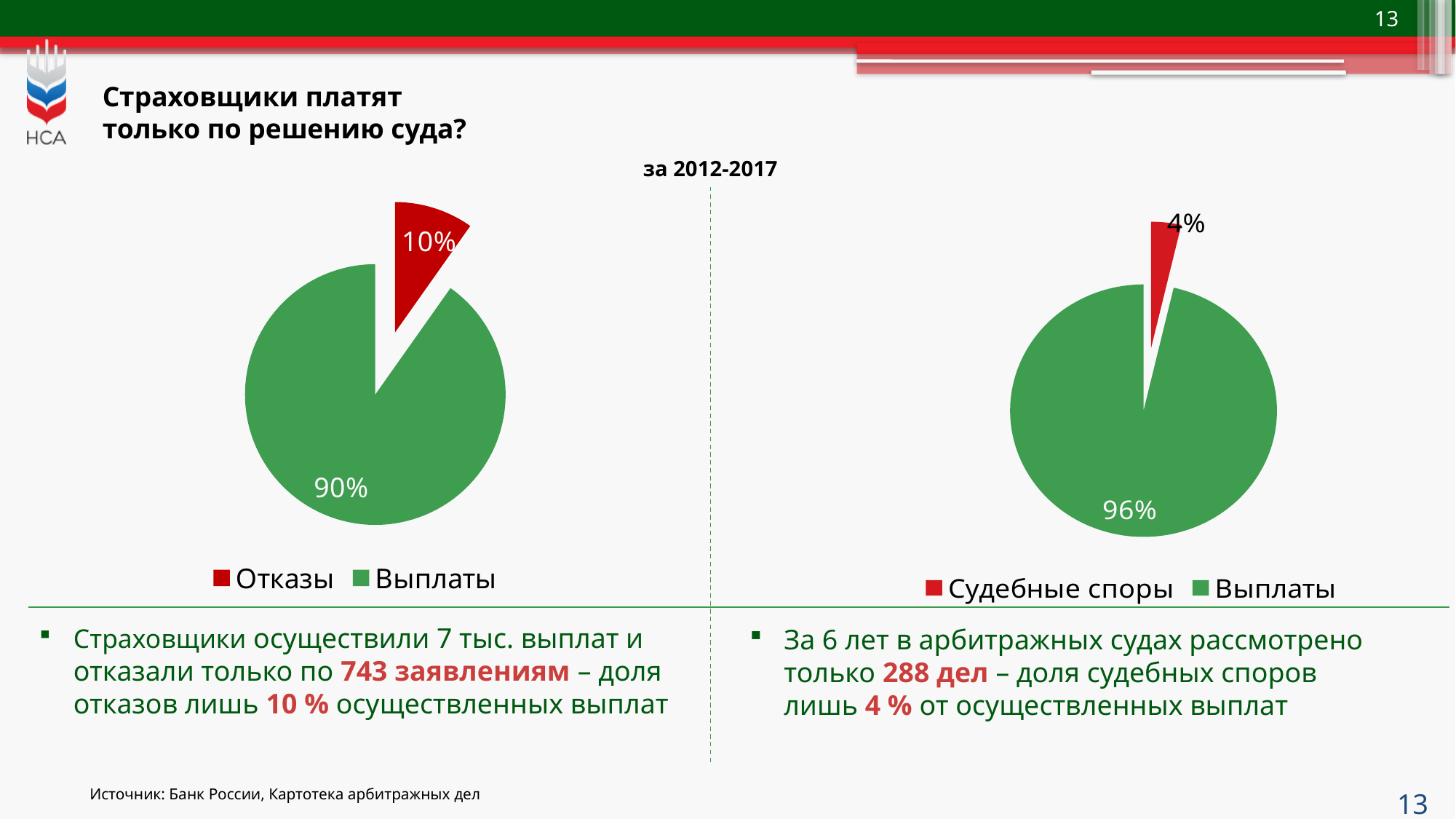
In the right pie chart, what is the difference in percentage points between Выплаты and Судебные споры? 92 What type of chart is used on the left side of the slide? Pie chart In the right pie chart, what share is labelled for Судебные споры? 4% In the right pie chart, what share is labelled for Выплаты? 96% In the left pie chart, what share is labelled for Отказы? 10% In the left pie chart, which category has the largest slice? Выплаты Which is larger: the Отказы share in the left pie chart or the Судебные споры share in the right pie chart? Отказы in the left pie chart How many categories does the legend of the right pie chart list? 2 In the left pie chart, what share is labelled for Выплаты? 90% In the left pie chart, what is the difference in percentage points between Выплаты and Отказы? 80 What colour is the Отказы slice in the left pie chart? Red In the right pie chart, which category has the smallest slice? Судебные споры